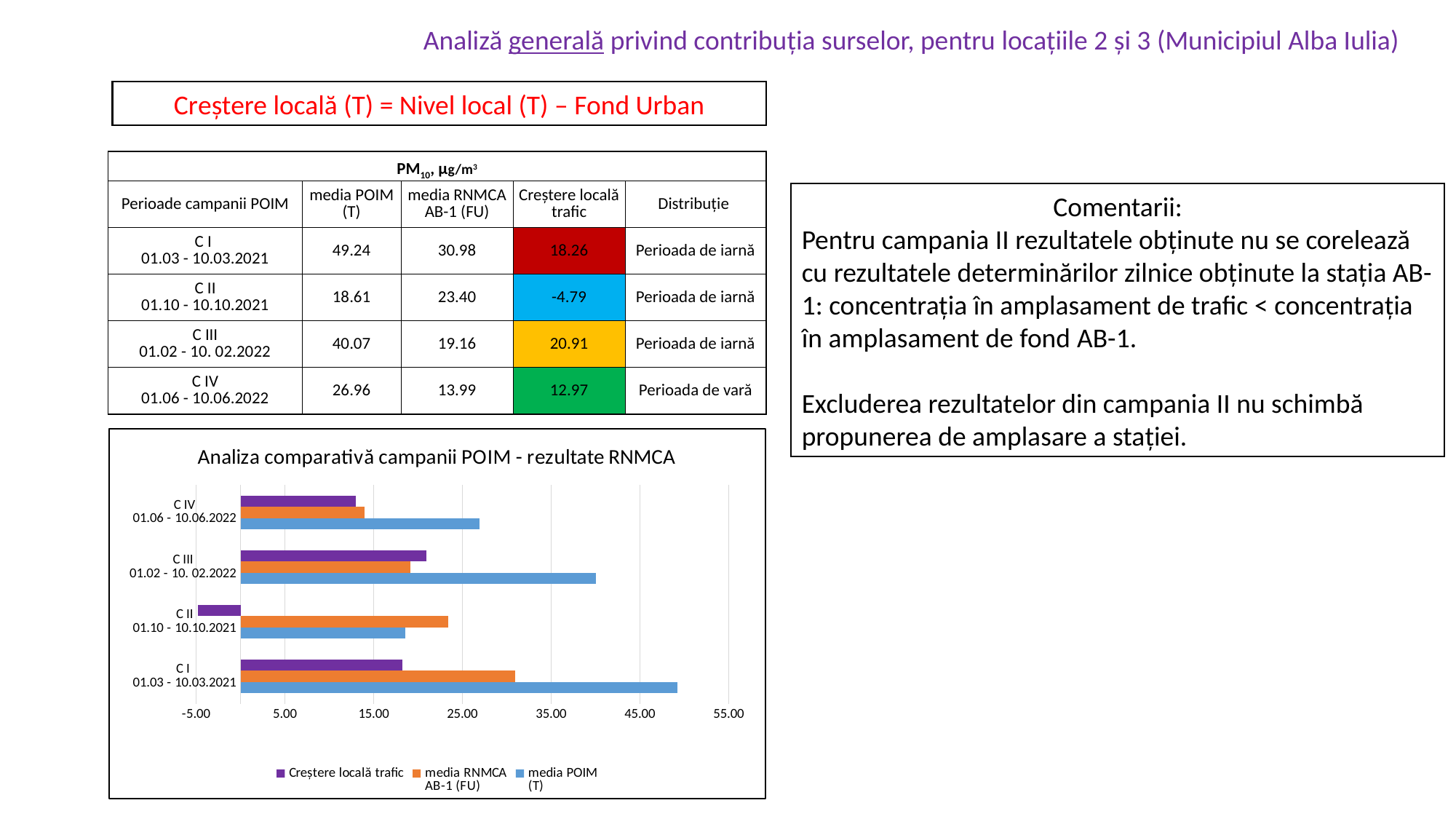
Which campaign has the highest value for media POIM (T) in the chart? C I 01.03 - 10.03.2021 How many series does the chart's legend list? 3 Which campaign has the lowest value for Creștere locală trafic in the chart? C II 01.10 - 10.10.2021 For C II 01.10 - 10.10.2021, which is larger: media RNMCA AB-1 (FU) or media POIM (T)? media RNMCA AB-1 (FU) How many campaign periods (categories) are plotted in the chart? 4 Which campaign has the lowest value for media POIM (T) in the chart? C II 01.10 - 10.10.2021 Is the media POIM (T) value for C I 01.03 - 10.03.2021 greater or less than 45.00? greater What is the media POIM (T) value for C III 01.02 - 10. 02.2022? 40.07 What kind of chart is shown on the slide? Bar chart Is the Creștere locală trafic value for C II 01.10 - 10.10.2021 greater or less than 5.00? less What is the difference between media POIM (T) and media RNMCA AB-1 (FU) for C I 01.03 - 10.03.2021? 18.26 What is the title of the chart on the slide? Analiza comparativă campanii POIM - rezultate RNMCA